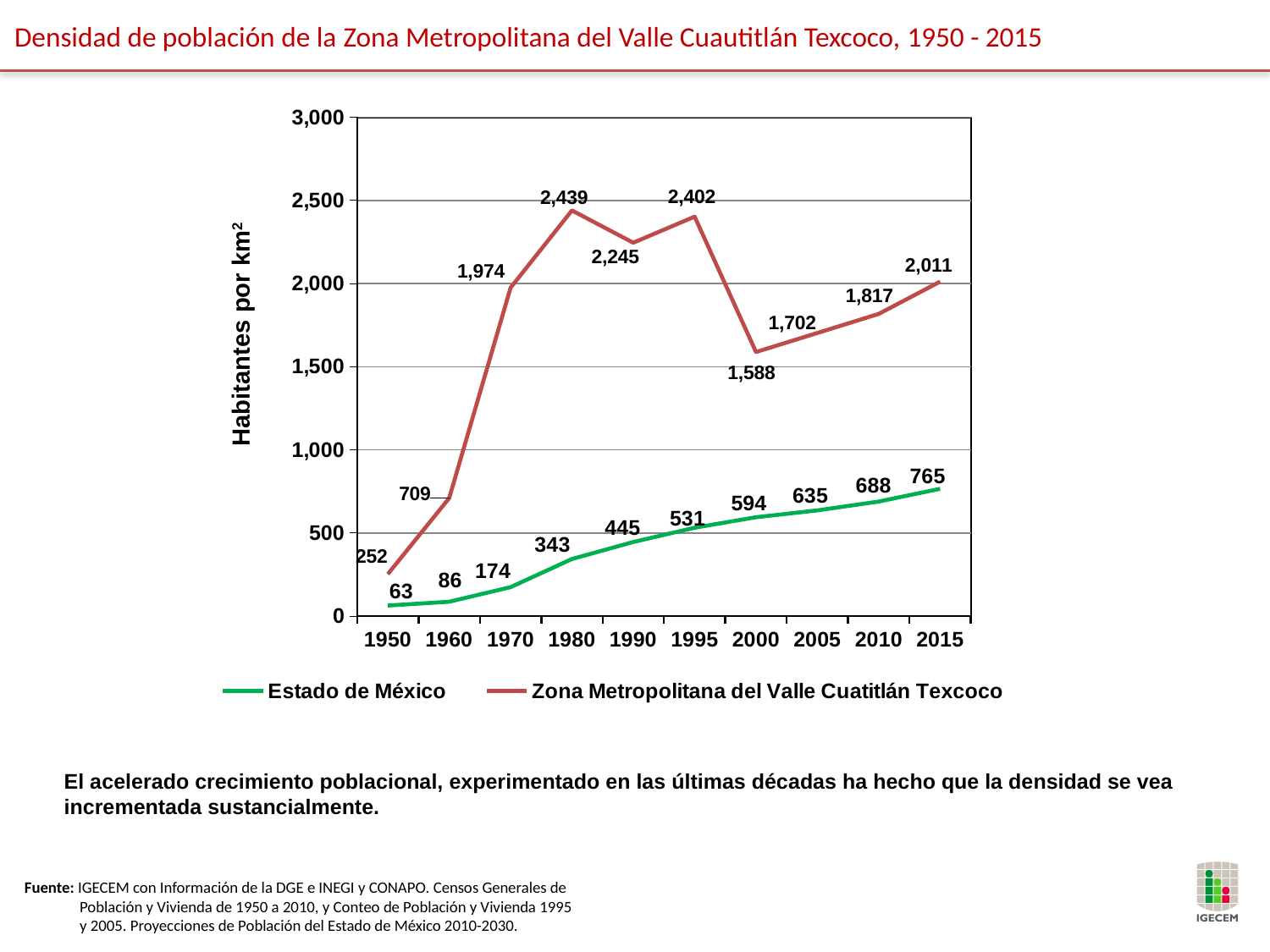
What is the label of the y axis? Habitantes por km² What is the difference between the Zona Metropolitana del Valle Cuatitlán Texcoco values in 1980 and 1990? 194 In which year does the Zona Metropolitana del Valle Cuatitlán Texcoco series reach its highest value? 1980 What is the value for Estado de México in 2015? 765 How many years are shown on the x axis? 10 How many series does the legend list? 2 What is the value for Zona Metropolitana del Valle Cuatitlán Texcoco in 2000? 1,588 Which series has the larger value in 2015, Estado de México or Zona Metropolitana del Valle Cuatitlán Texcoco? Zona Metropolitana del Valle Cuatitlán Texcoco What is the value for Estado de México in 1980? 343 What type of chart is shown on the slide? Line chart Does the Estado de México series rise or fall from 1950 to 2015? Rise In which year is the Estado de México series lowest? 1950